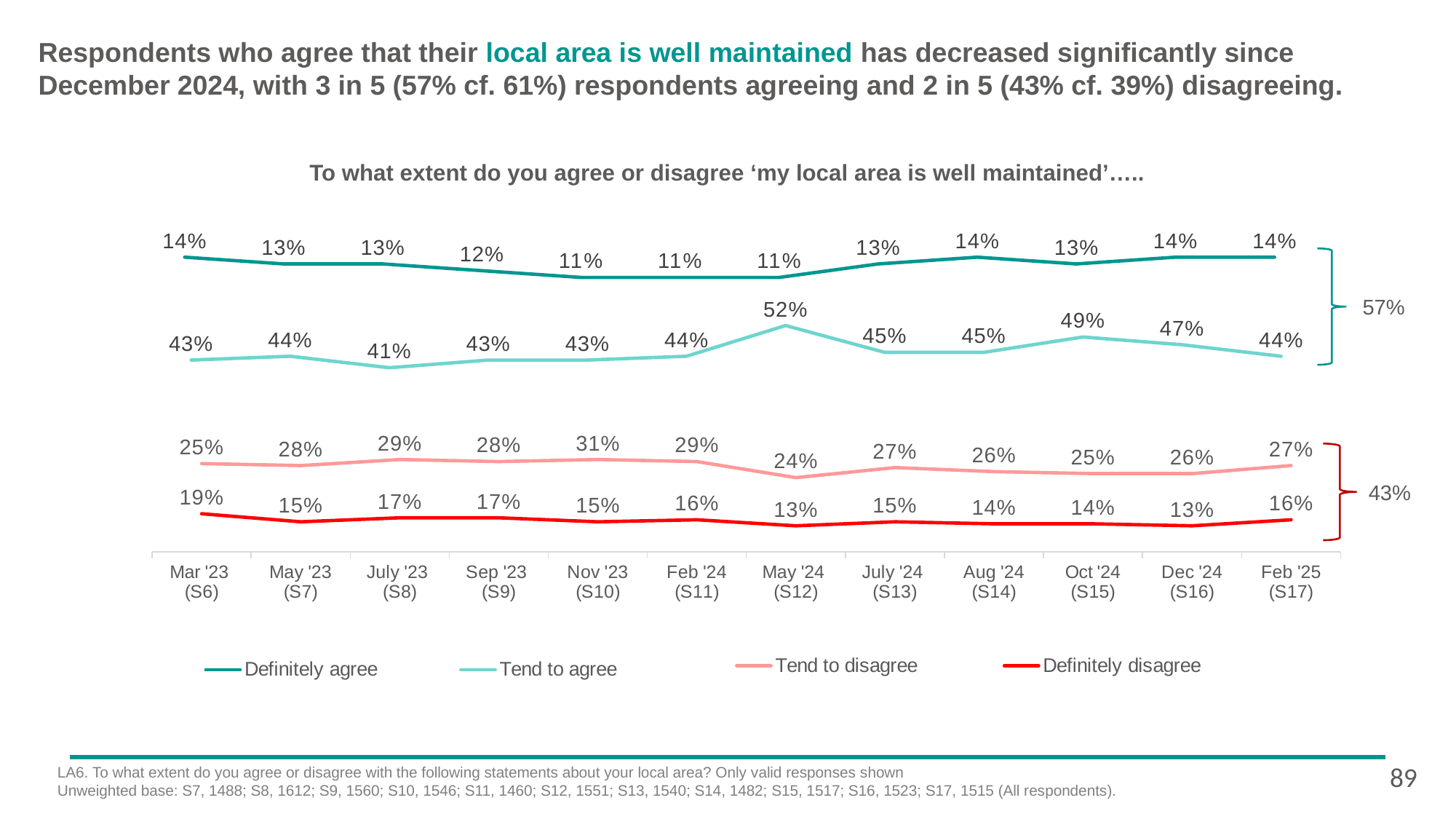
How many series does the legend list? 4 Which is larger in Feb '24 (S11): 'Tend to disagree' or 'Definitely disagree'? Tend to disagree In which period is the 'Tend to agree' value lowest? July '23 (S8) What kind of chart is shown on the slide? Line chart What is the value for 'Tend to disagree' in Nov '23 (S10)? 31% What is the value for 'Definitely disagree' in Mar '23 (S6)? 19% How many time points are shown on the x axis? 12 What is the difference between the 'Tend to agree' values in Oct '24 (S15) and Feb '25 (S17)? 5 percentage points What total percentage is shown by the bracket for the two agree series in Feb '25? 57% What is the value for 'Definitely agree' in Feb '25 (S17)? 14% What is the value for 'Tend to agree' in May '24 (S12)? 52% In which period is the 'Tend to agree' value highest? May '24 (S12)